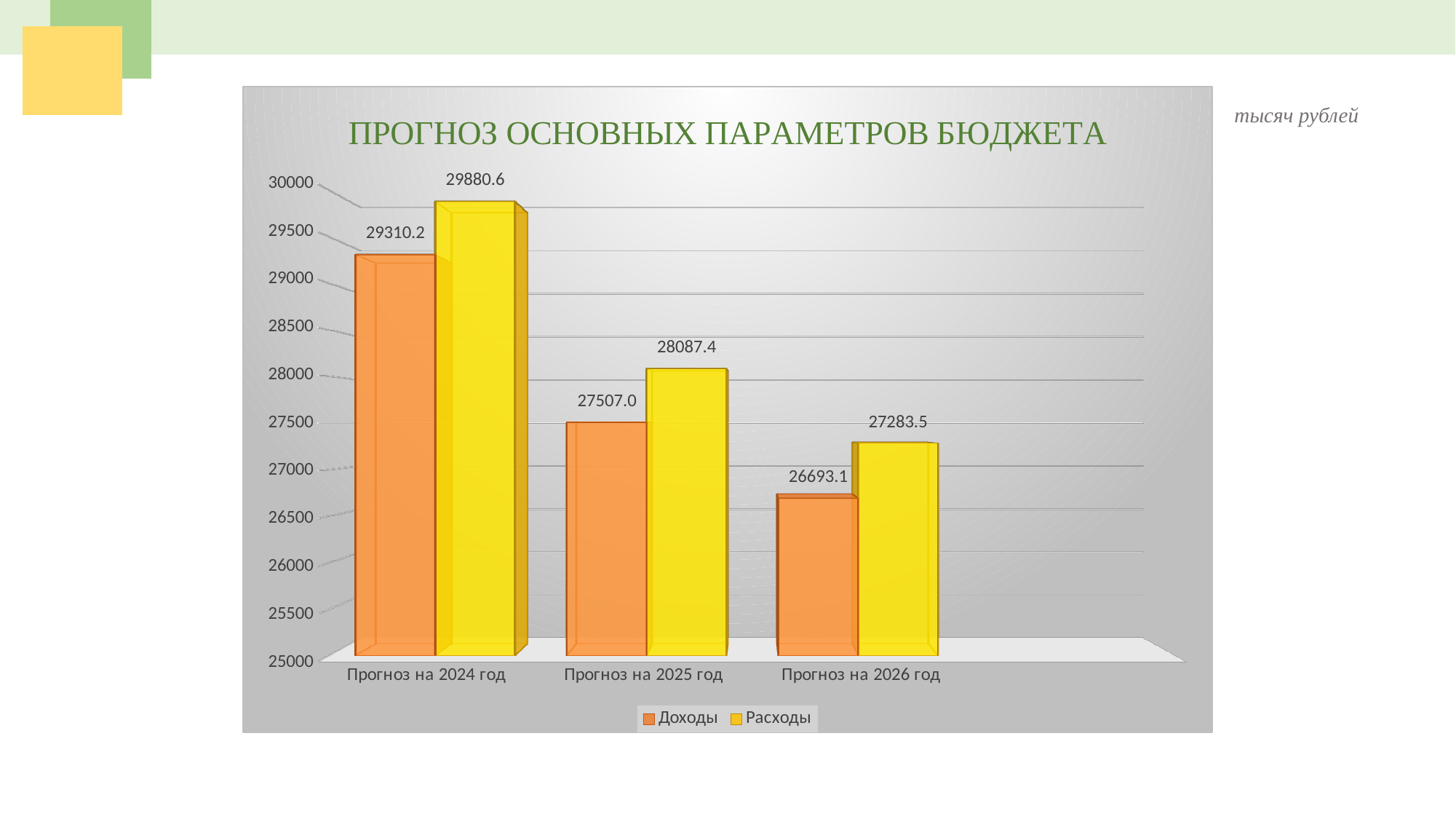
Do the Расходы values rise or fall from Прогноз на 2024 год to Прогноз на 2026 год? Fall How many categories are shown on the x axis? 3 What is the value of Доходы for Прогноз на 2026 год? 26693.1 What is the value of Доходы for Прогноз на 2024 год? 29310.2 Which is larger for Прогноз на 2026 год: Доходы or Расходы? Расходы What kind of chart is shown on the slide? Bar chart Which category has the highest value for Расходы? Прогноз на 2024 год What is the difference between Расходы and Доходы for Прогноз на 2024 год? 570.4 Which category has the lowest value for Доходы? Прогноз на 2026 год What is the difference between Доходы for Прогноз на 2024 год and Доходы for Прогноз на 2026 год? 2617.1 How many series does the legend list? 2 What is the value of Расходы for Прогноз на 2025 год? 28087.4